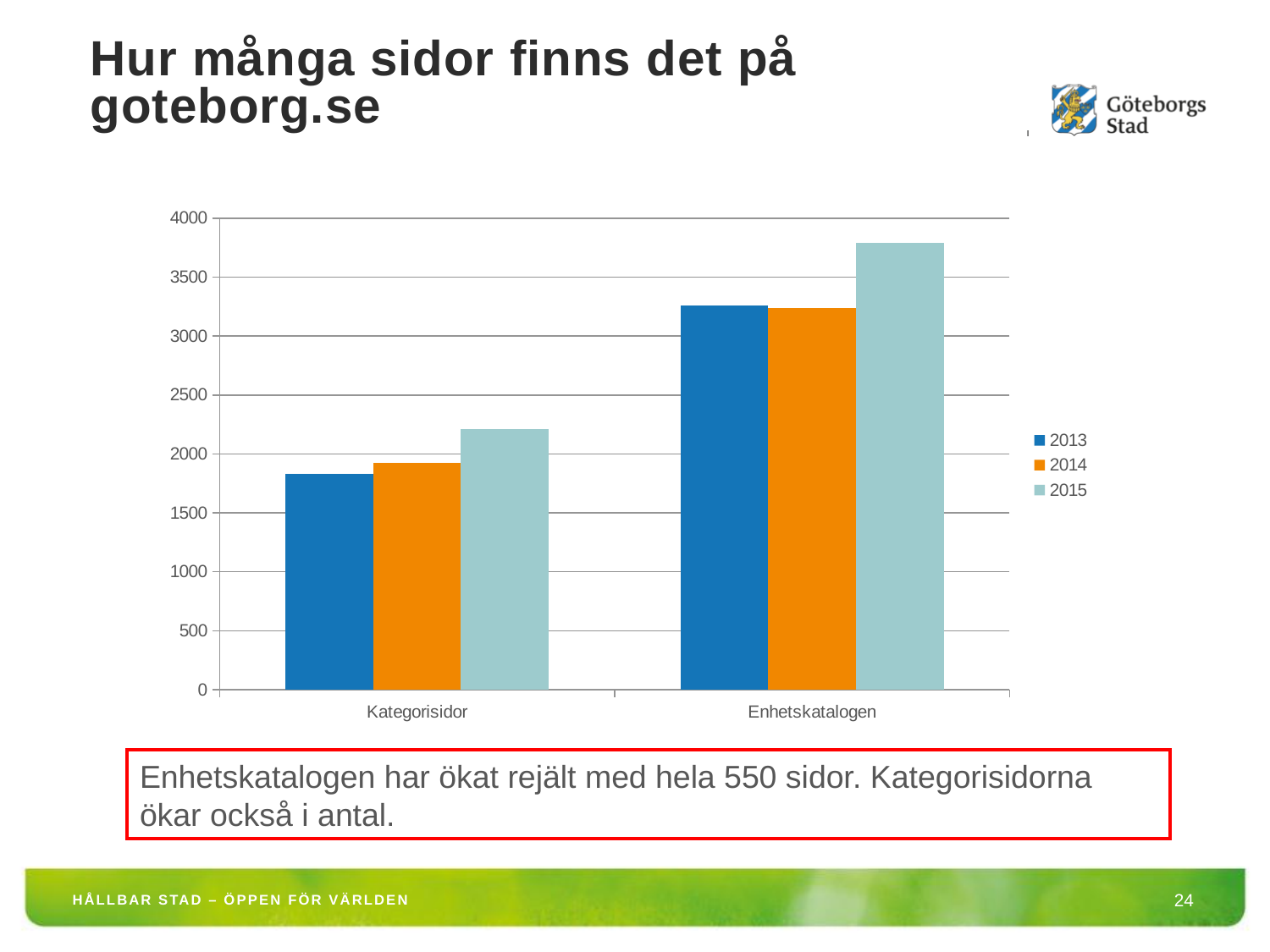
For Enhetskatalogen, which year has the highest bar? 2015 Is the value for Kategorisidor in 2015 greater or less than 2000? greater Which category has the highest bar overall? Enhetskatalogen Is the value for Kategorisidor in 2013 greater or less than 2000? less For Kategorisidor, which year has the lowest bar? 2013 How many categories are shown on the x axis? 2 Which category has the lowest bar overall? Kategorisidor What kind of chart is shown on the slide? bar chart Which is larger for 2015: Kategorisidor or Enhetskatalogen? Enhetskatalogen How many series does the legend list? 3 Is the value for Enhetskatalogen in 2015 greater or less than 3500? greater Which years are listed in the legend? 2013, 2014, 2015